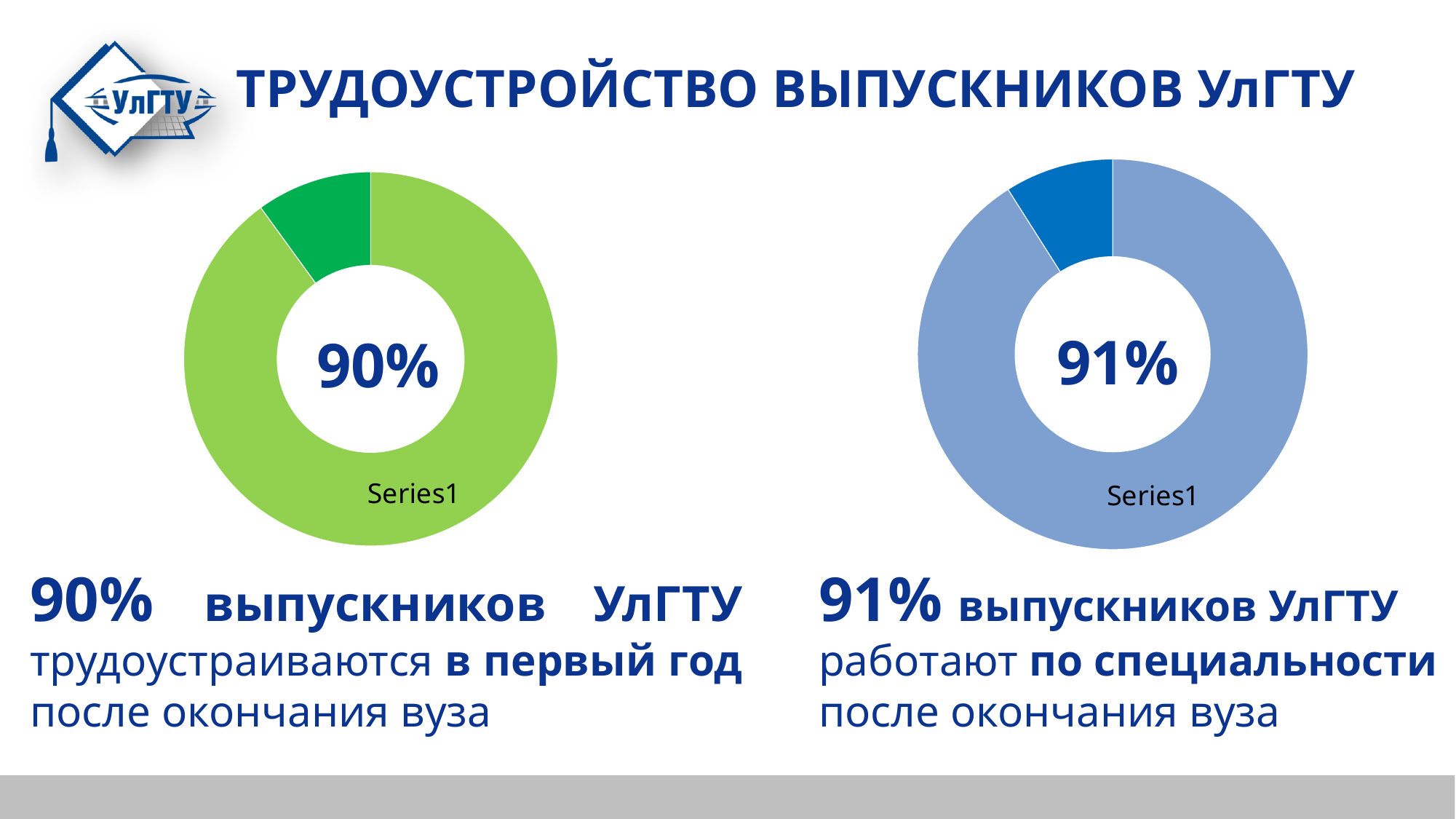
What percentage is shown in the centre of the left chart? 90% How many slices does the left chart have? 2 What kind of chart is the right chart on the slide? doughnut (pie) chart What kind of chart is the left chart on the slide? doughnut (pie) chart What is the difference between the percentage shown on the right chart and the percentage shown on the left chart? 1% Which chart shows the higher percentage, the left chart or the right chart? the right chart What colour is the large slice of the right chart? light blue In the left chart, which slice is larger, the light green slice or the dark green slice? the light green slice In the right chart, which slice is smaller, the light blue slice or the dark blue slice? the dark blue slice What series name is printed on the left chart? Series1 What percentage is shown in the centre of the right chart? 91% How many slices does the right chart have? 2